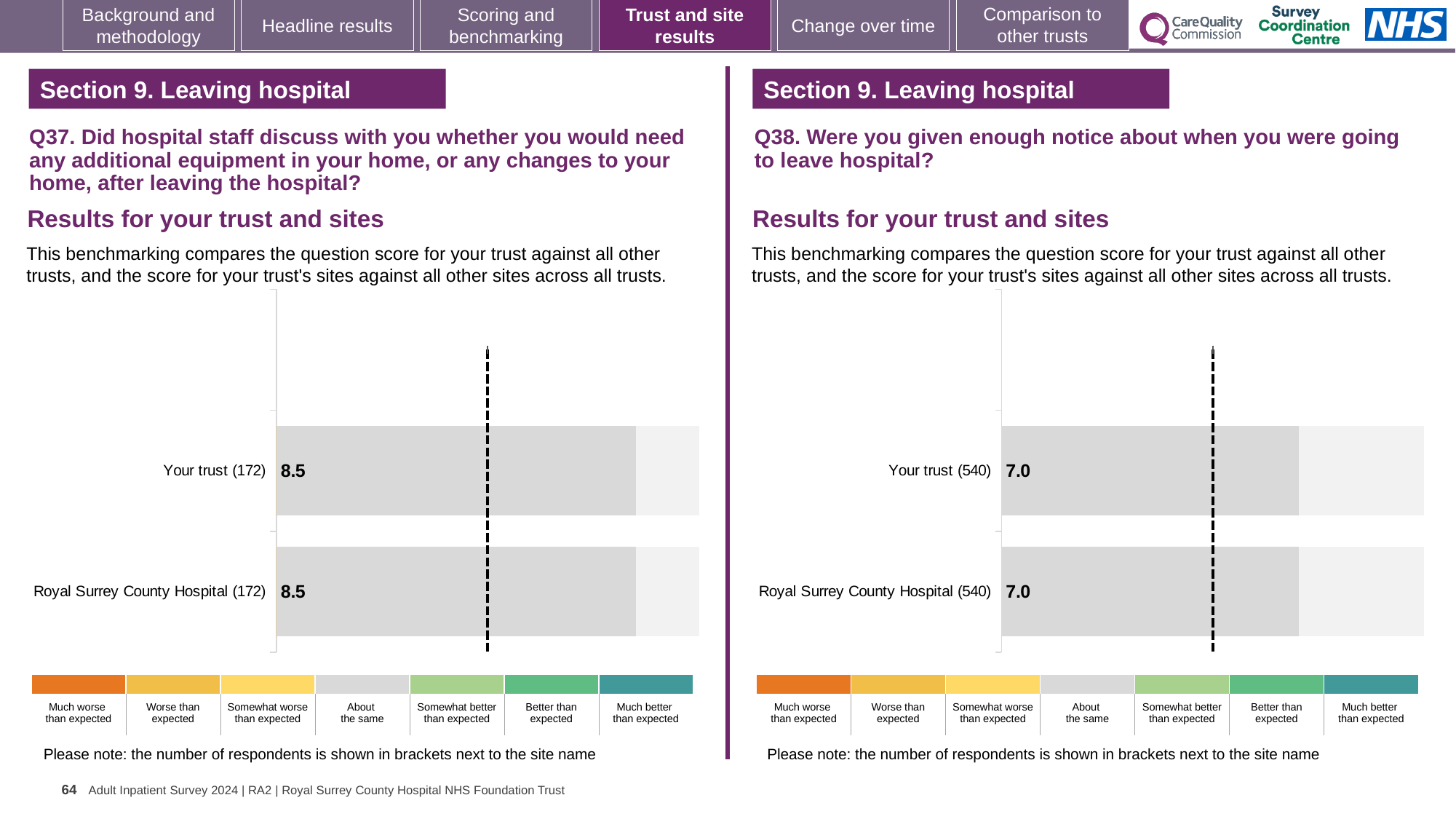
On the Q38 chart (right), what is the score for Royal Surrey County Hospital? 7.0 How many bars are plotted on the Q37 chart (left)? 2 On the Q37 chart (left), what is the score for Royal Surrey County Hospital? 8.5 On the Q37 chart (left), what is the score for Your trust? 8.5 What kind of chart is used on the Q37 chart (left)? Bar chart Is the score for Your trust on the Q37 chart (left) larger or smaller than the score for Your trust on the Q38 chart (right)? Larger How many bars are plotted on the Q38 chart (right)? 2 On the Q38 chart (right), how many respondents are shown in brackets for Royal Surrey County Hospital? 540 On the Q38 chart (right), what is the difference between the score for Your trust and the score for Royal Surrey County Hospital? 0.0 On the Q38 chart (right), what is the score for Your trust? 7.0 On the Q37 chart (left), what is the difference between the score for Your trust and the score for Royal Surrey County Hospital? 0.0 On the Q37 chart (left), how many respondents are shown in brackets for Your trust? 172